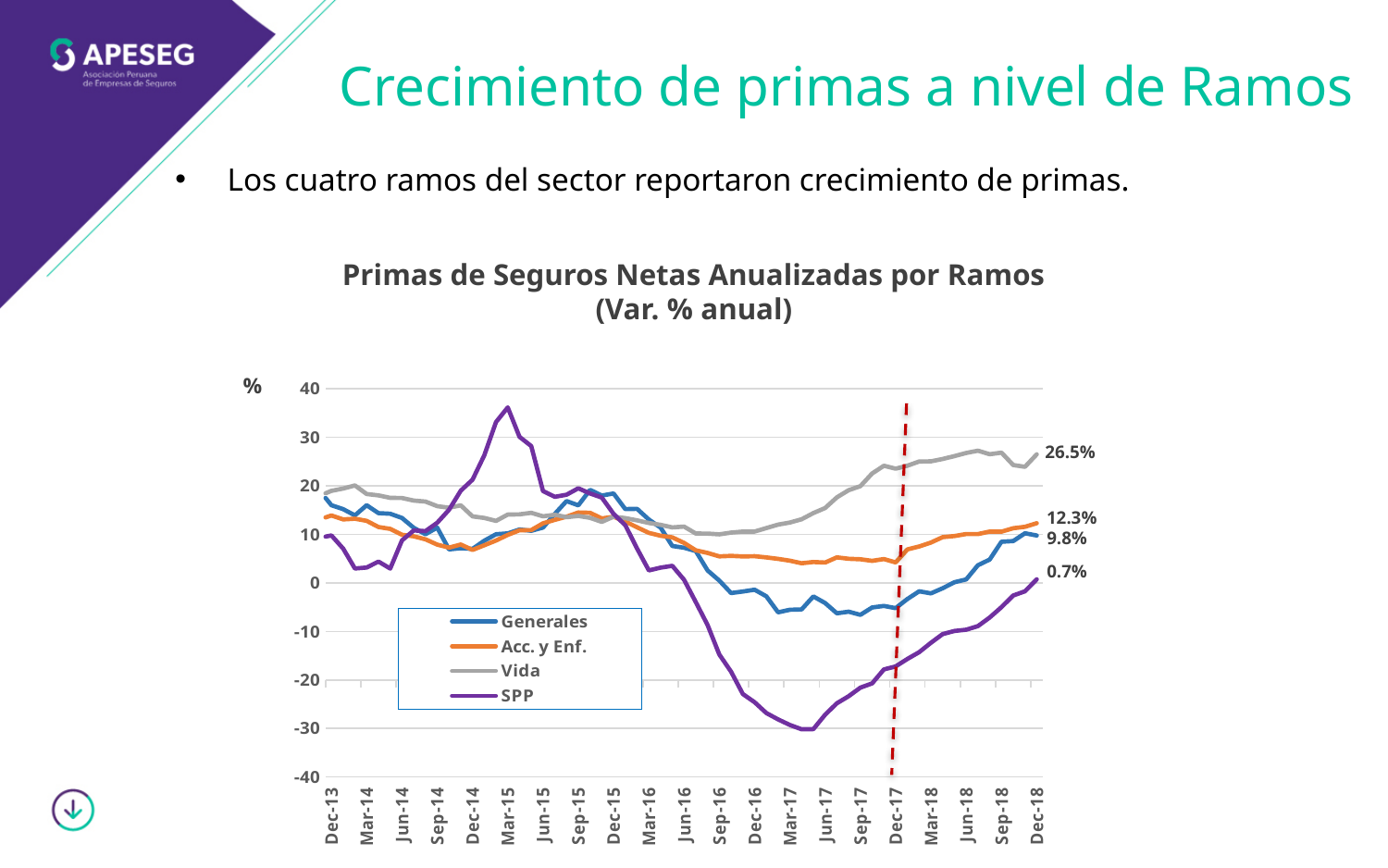
Is the value for SPP at Mar-15 greater or less than 30? greater What is the value for Generales at Dec-18? 9.8% What is the difference between the Vida and SPP values at Dec-18? 25.8 percentage points Is the value for SPP at Mar-17 greater or less than -20? less What is the value for Acc. y Enf. at Dec-18? 12.3% What is the value for Vida at Dec-18? 26.5% Which series has the lowest value at Dec-18? SPP Which series has the highest value at Dec-18? Vida How many series does the legend list? 4 At Dec-18, which is larger: Acc. y Enf. or Generales? Acc. y Enf. What is the value for SPP at Dec-18? 0.7% What kind of chart is shown on the slide? Line chart